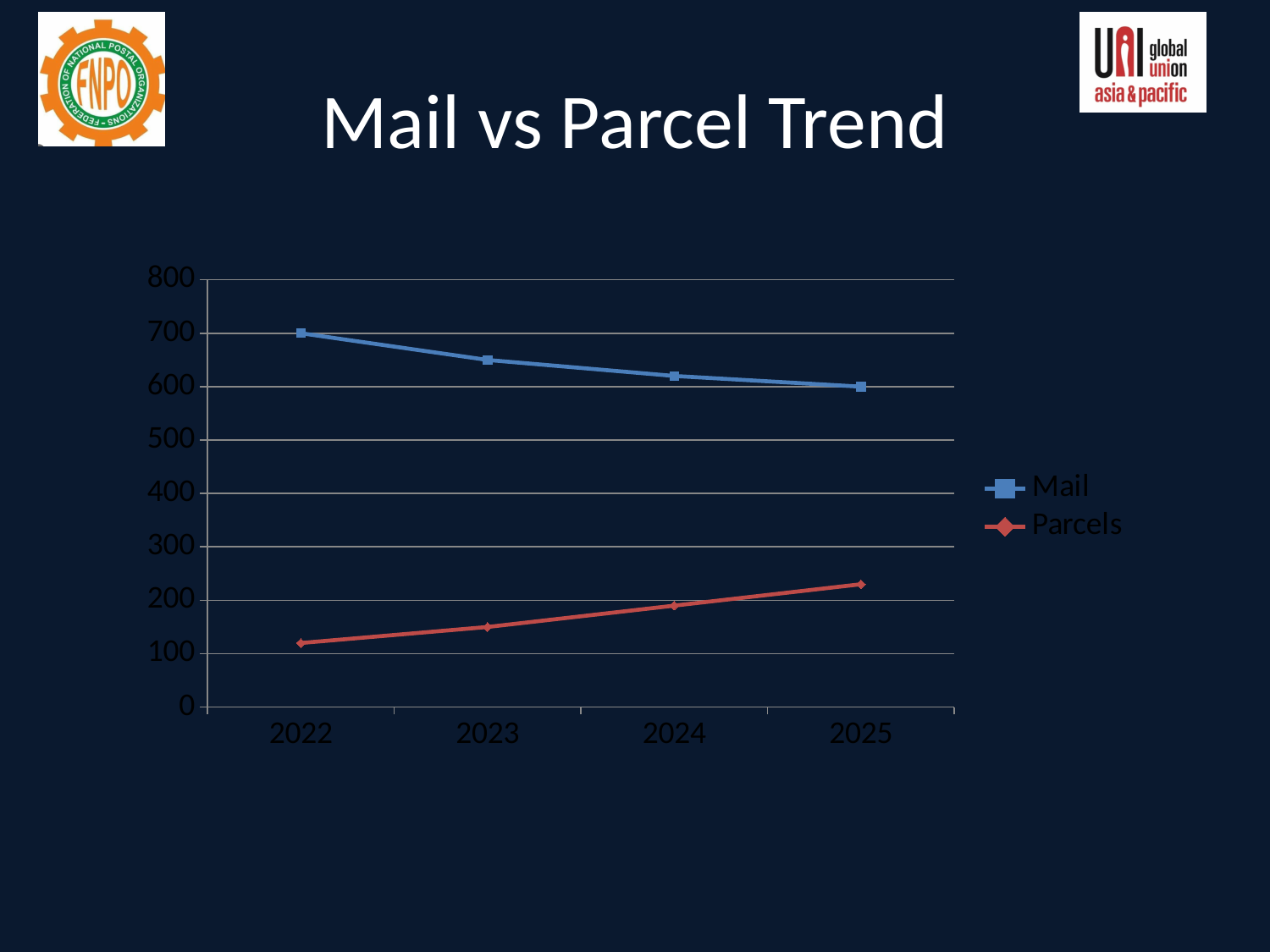
In which year is the Parcels value highest? 2025 Do the Mail values rise or fall from 2022 to 2025? fall Is the value for Parcels in 2025 greater or less than 200? greater Is the value for Parcels in 2022 greater or less than 200? less Do the Parcels values rise or fall from 2022 to 2025? rise In 2024, which series has the larger value, Mail or Parcels? Mail What is the value for Mail in 2022? 700 What is the value for Mail in 2025? 600 How many years are plotted along the x axis? 4 What kind of chart is shown on the slide? line chart Is the value for Mail in 2023 greater or less than 600? greater How many series does the legend list? 2